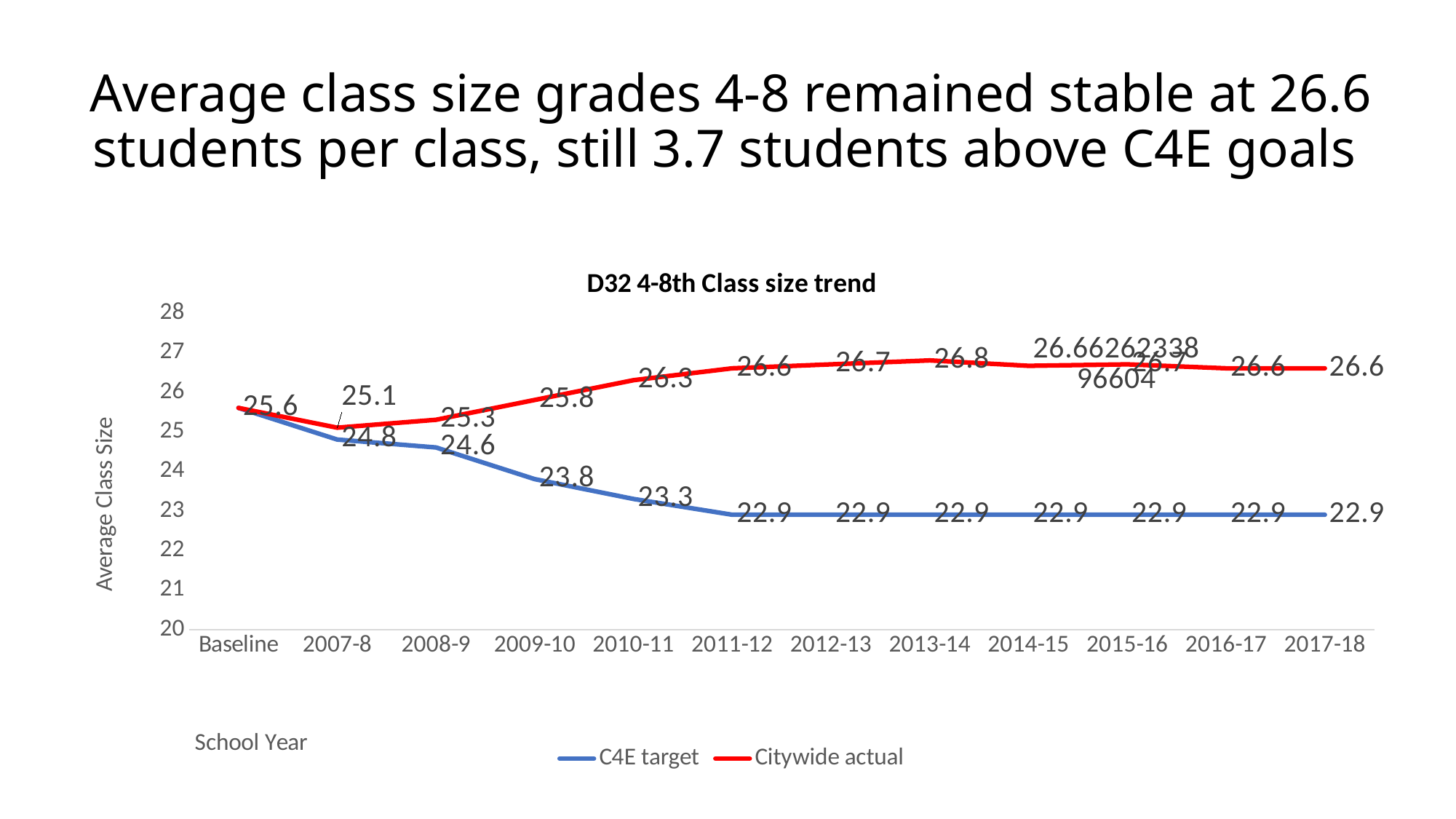
How many school-year categories are shown on the x axis? 12 What is the title of the chart? D32 4-8th Class size trend Does the C4E target rise or fall from Baseline to 2011-12? fall What is the difference between the Citywide actual and the C4E target in 2017-18? 3.7 What is the Citywide actual value for 2008-9? 25.3 What is the Citywide actual value for 2010-11? 26.3 In 2011-12, which series has the higher value, C4E target or Citywide actual? Citywide actual How many series does the legend list? 2 What is the C4E target value for 2009-10? 23.8 In which school year is the Citywide actual value lowest? 2007-8 What is the C4E target value for 2017-18? 22.9 What kind of chart is shown on the slide? line chart